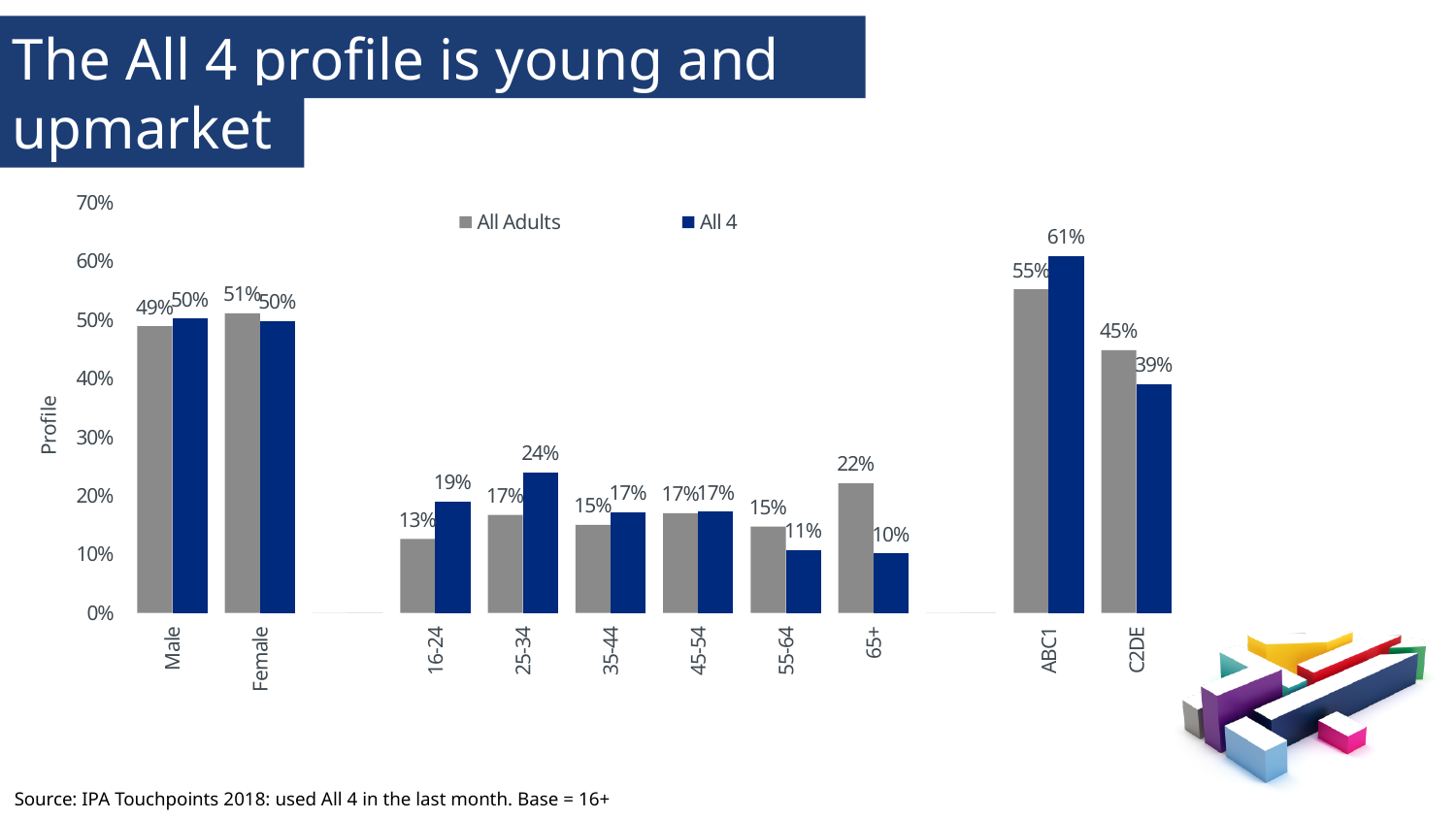
What is the difference between the All Adults and All 4 values for C2DE? 6% How many labelled categories are shown on the x axis? 10 What is the All 4 value for the 16-24 age group? 19% What is the title of the slide containing the chart? The All 4 profile is young and upmarket What is the difference between the All 4 and All Adults values for 25-34? 7% What is the All 4 value for the 65+ age group? 10% For the 55-64 age group, which is larger: the All Adults value or the All 4 value? All Adults What is the All Adults value for ABC1? 55% How many series does the legend list? 2 Which category has the highest All 4 value? ABC1 Which category has the lowest All 4 value? 65+ What kind of chart is shown on the slide? Bar chart